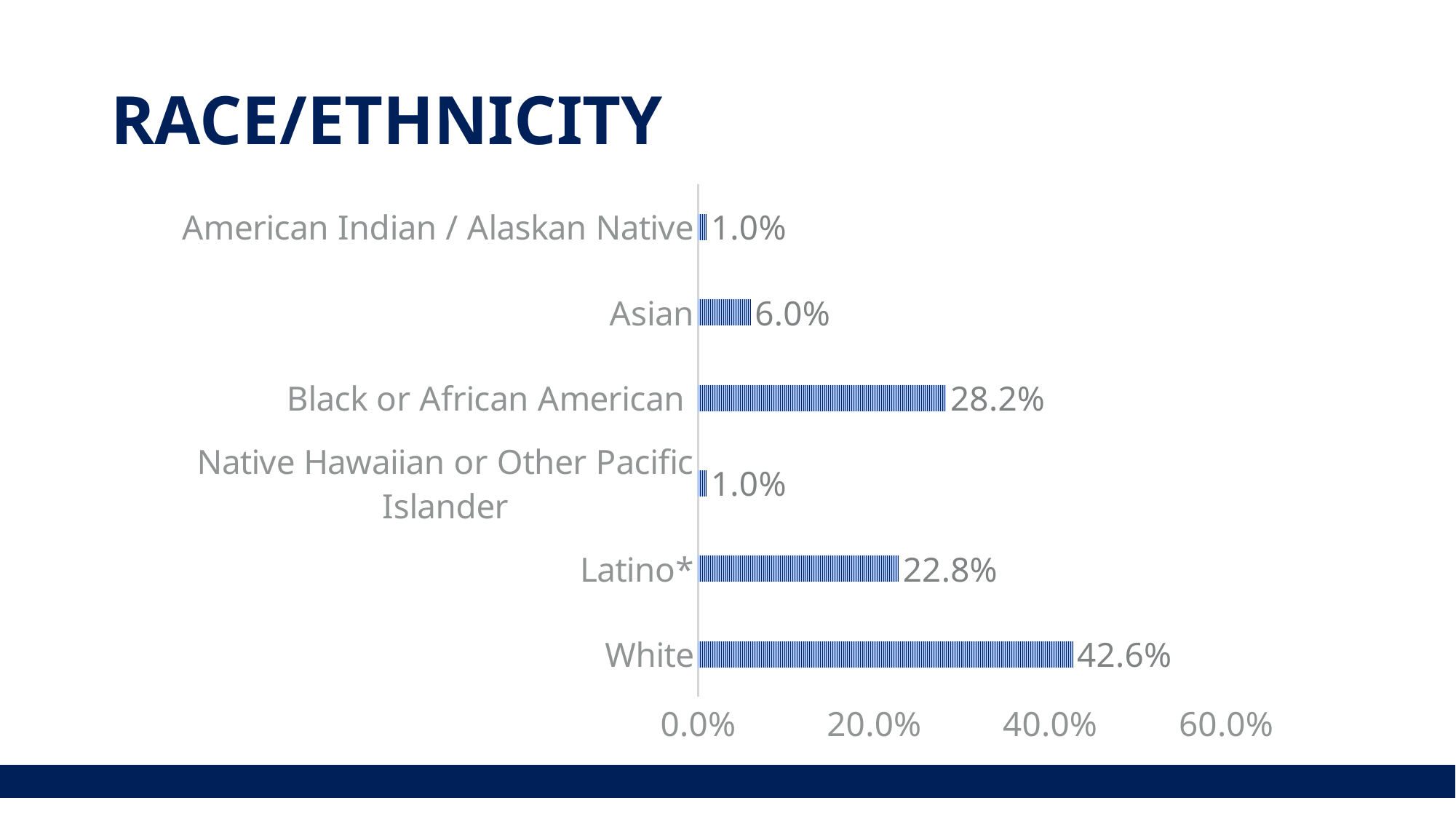
What is the value for Black or African American? 28.2% What is the value for Asian? 6.0% What is the value for Latino*? 22.8% What is the difference between the values for Black or African American and Latino*? 5.4% What is the title of the slide? RACE/ETHNICITY Which is larger, the value for Asian or the value for Latino*? Latino* How many categories are shown in the chart? 6 What is the difference between the values for White and Black or African American? 14.4% Which category has the highest value? White Is the value for White greater or less than 40.0%? greater What is the value for White? 42.6% What kind of chart is shown on the slide? Bar chart